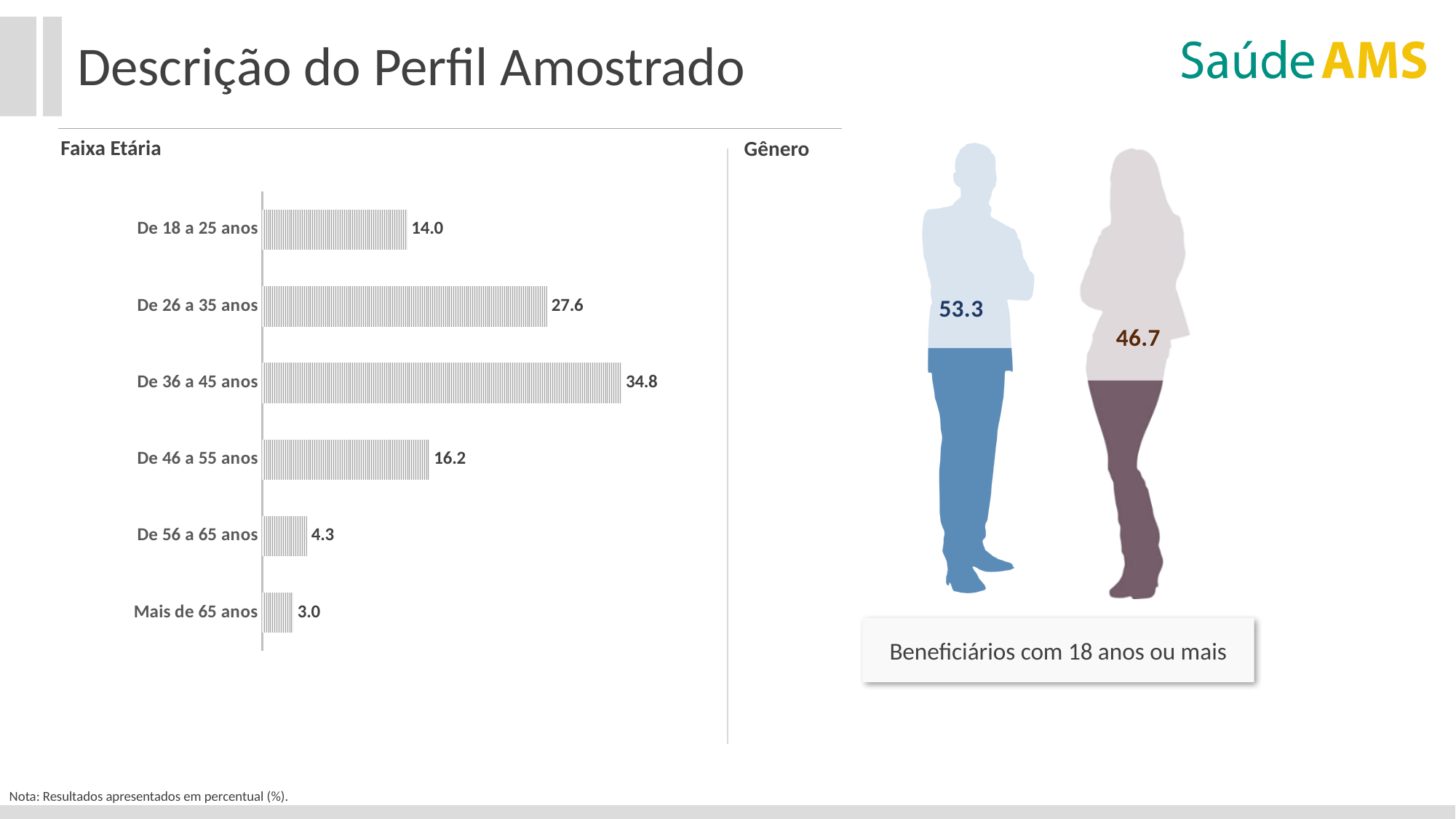
In the Faixa Etária chart, what is the difference between the values for De 26 a 35 anos and De 46 a 55 anos? 11.4 In the Faixa Etária chart, what is the value for De 36 a 45 anos? 34.8 In the Faixa Etária chart, what is the value for De 18 a 25 anos? 14.0 In the Gênero section, what is the value shown for the male figure? 53.3 In the Faixa Etária chart, which age group has the highest value? De 36 a 45 anos In the Faixa Etária chart, what is the difference between the values for De 56 a 65 anos and Mais de 65 anos? 1.3 In the Faixa Etária chart, which age group has the lowest value? Mais de 65 anos According to the note at the bottom of the slide, in what unit are the results presented? Percentual (%) What kind of chart is the Faixa Etária chart? Bar chart How many age groups are shown in the Faixa Etária chart? 6 In the Faixa Etária chart, what is the value for Mais de 65 anos? 3.0 In the Faixa Etária chart, which is larger: the value for De 18 a 25 anos or De 46 a 55 anos? De 46 a 55 anos